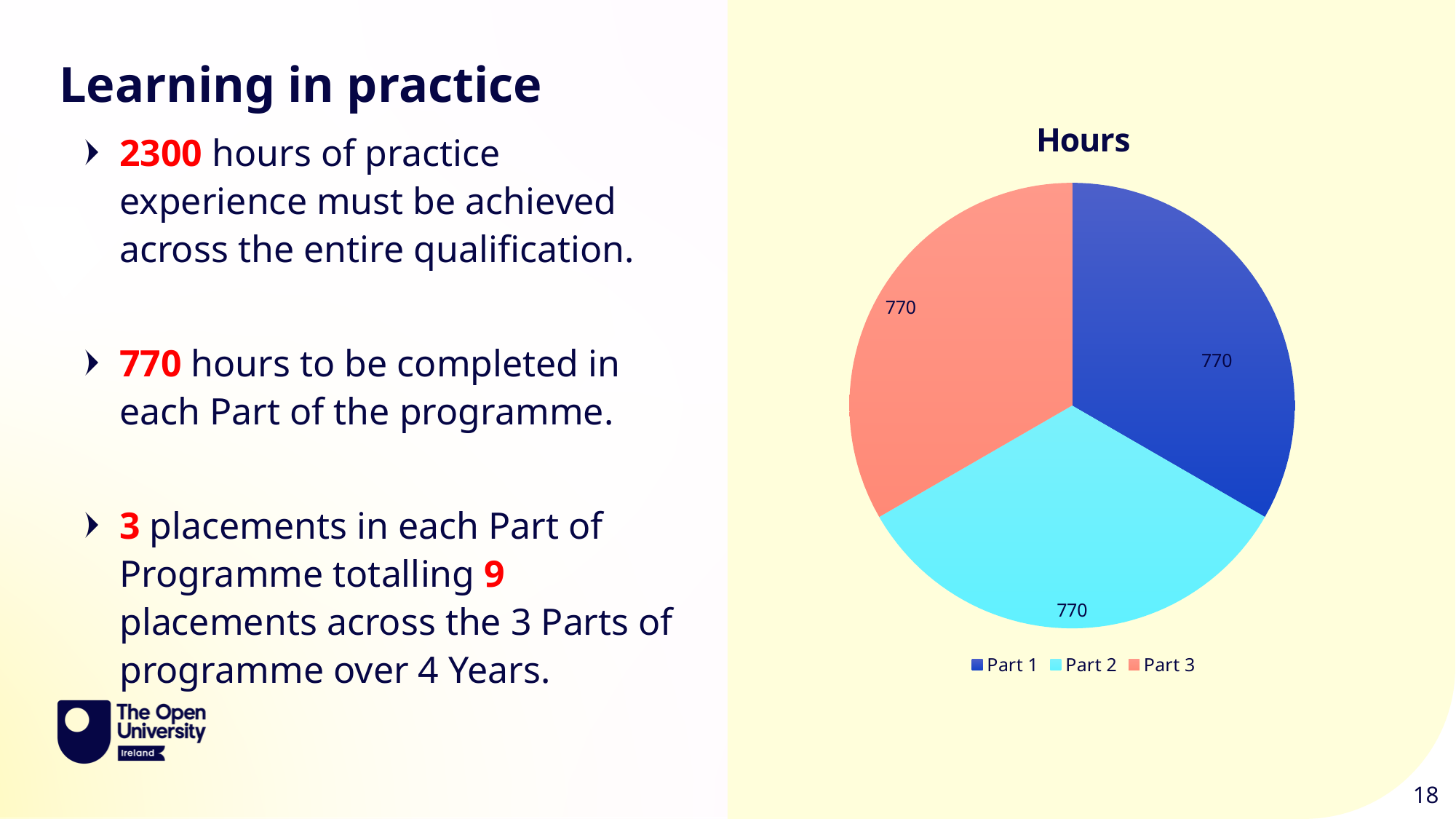
How many entries does the legend list? 3 What is the value for Part 2 in the pie chart? 770 Which legend entry is shown in dark blue? Part 1 What share of the pie does Part 2 represent? 33.3% What type of chart is shown on the slide? pie chart What is the total of all slices in the pie chart? 2310 What is the title of the chart? Hours How many slices does the pie chart have? 3 What is the value for Part 3 in the pie chart? 770 What is the difference between the values for Part 1 and Part 3? 0 What is the value for Part 1 in the pie chart? 770